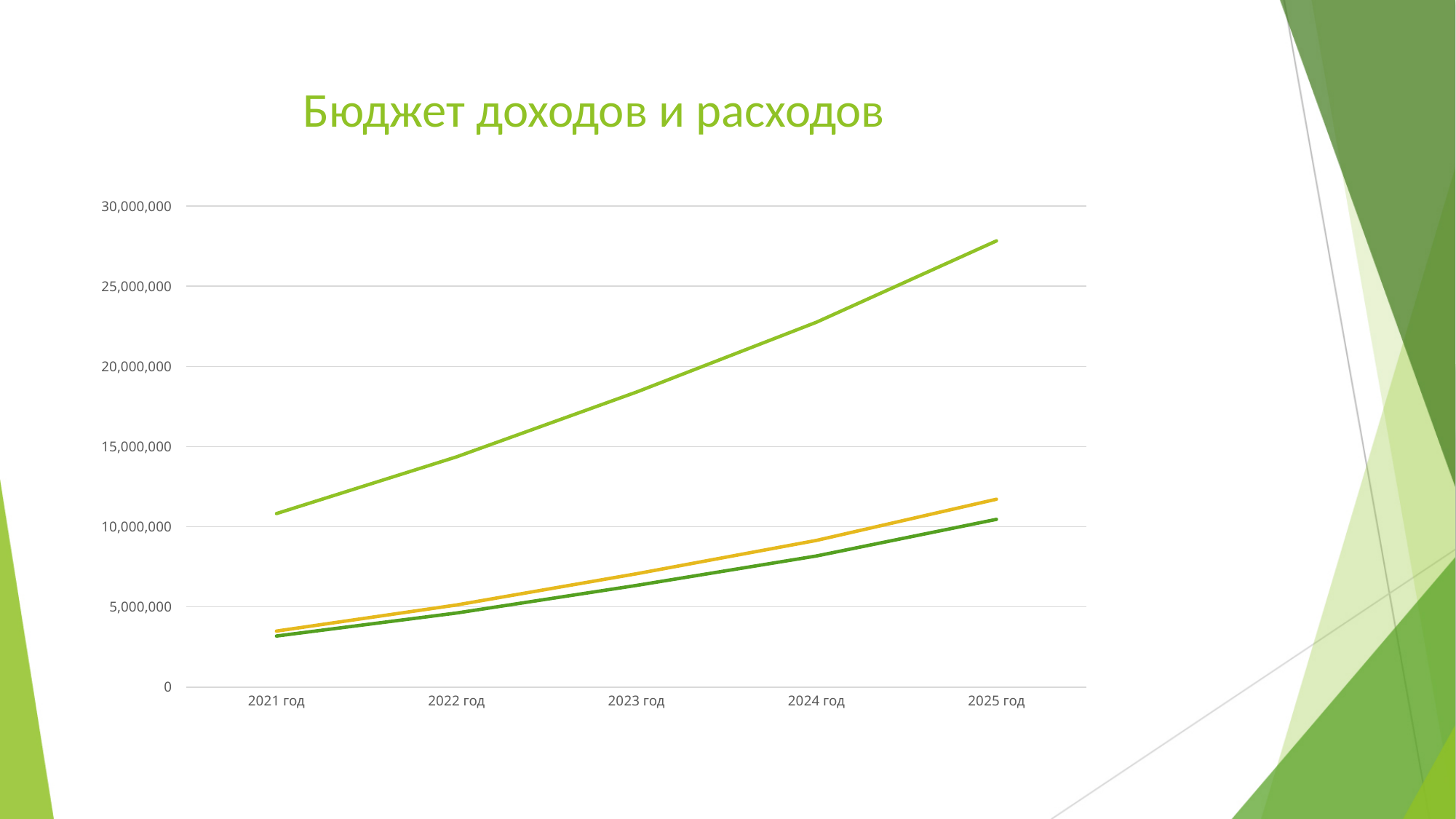
How many lines are plotted on the chart? 3 Is the value of the light green line for 2023 год greater or less than 20,000,000? less Is the value of the orange line for 2021 год greater or less than 5,000,000? less Which line has the highest value in 2025 год: the light green line or the orange line? the light green line Is the value of the orange line for 2025 год greater or less than 10,000,000? greater Does the top (light green) line rise or fall from 2021 год to 2025 год? rise What kind of chart is shown on the slide? line chart What is the highest value labelled on the y axis of the chart? 30,000,000 How many years are shown along the x axis of the chart? 5 What is the title of the chart on the slide? Бюджет доходов и расходов